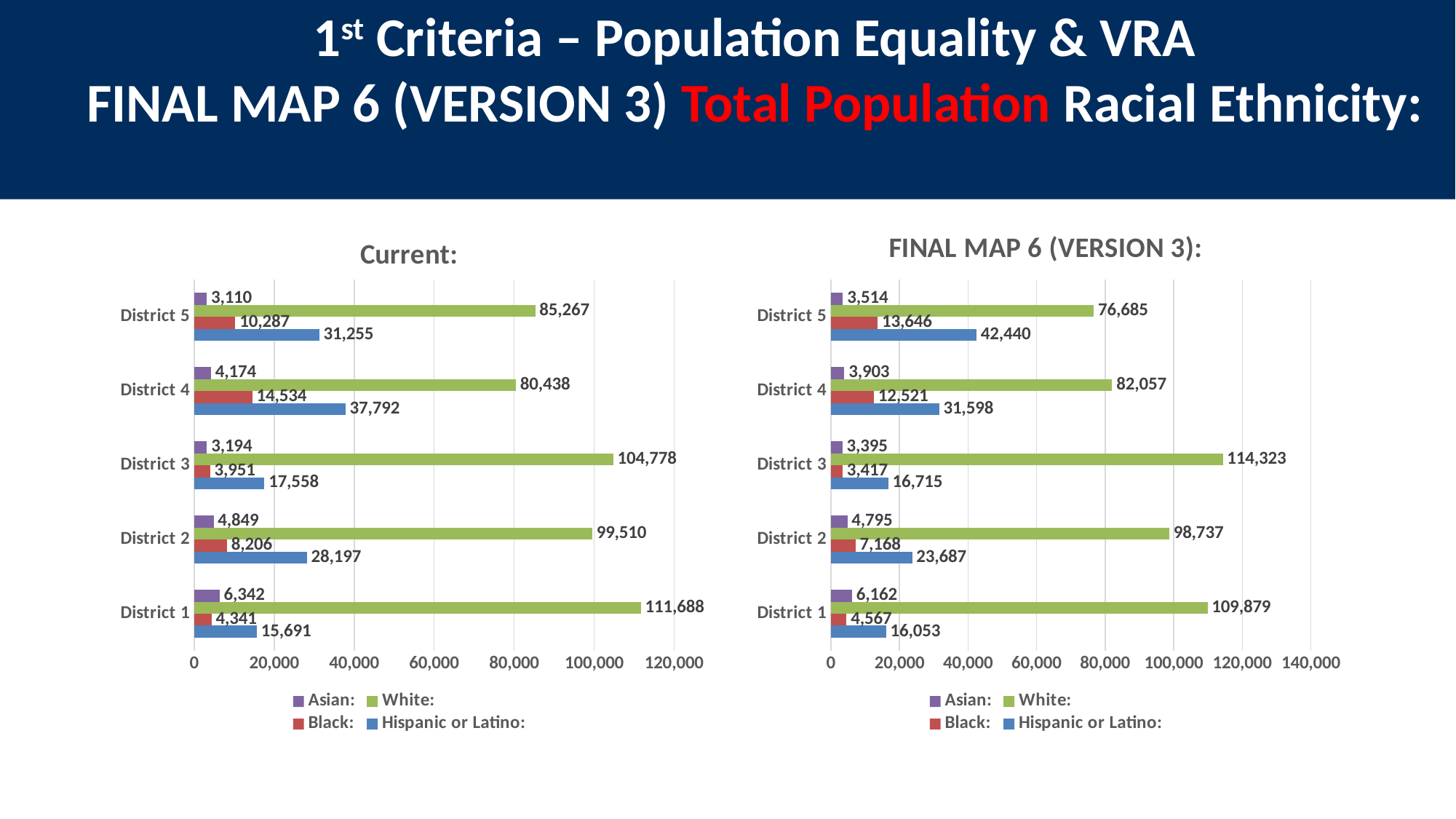
In the 'FINAL MAP 6 (VERSION 3):' chart, what is the Hispanic or Latino population for District 5? 42,440 How many series does the legend of the 'FINAL MAP 6 (VERSION 3):' chart list? 4 In the 'Current:' chart, which district has the highest White population? District 1 In the 'Current:' chart, what is the difference between the Hispanic or Latino populations of District 4 and District 1? 22,101 In the 'FINAL MAP 6 (VERSION 3):' chart, is the White population for District 3 greater or less than 100,000? greater In the 'FINAL MAP 6 (VERSION 3):' chart, which district has the lowest Hispanic or Latino population? District 1 In the 'Current:' chart, what is the White population for District 3? 104,778 What type of chart is the 'Current:' chart? Bar chart In the 'Current:' chart, which colour represents the Hispanic or Latino series? Blue Which is larger: the White population of District 5 in the 'Current:' chart or in the 'FINAL MAP 6 (VERSION 3):' chart? Current: In the 'FINAL MAP 6 (VERSION 3):' chart, what is the Black population for District 2? 7,168 How many districts are shown in the 'Current:' chart? 5